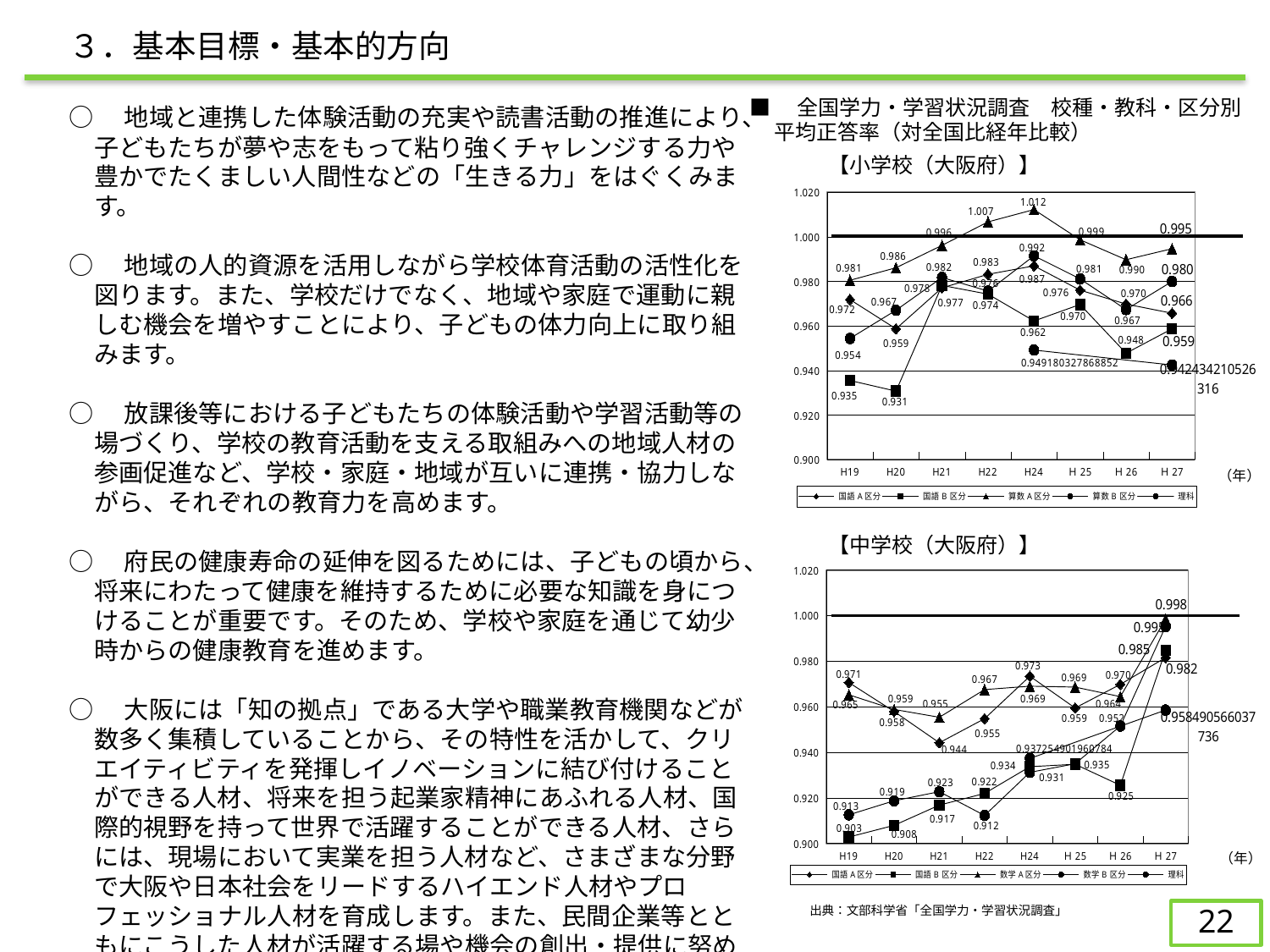
How many years are shown on the x axis of the 【小学校（大阪府）】 chart? 8 How many series does the legend of the 【中学校（大阪府）】 chart list? 5 In the 【中学校（大阪府）】 chart, does the 国語B区分 line rise or fall overall from H19 to H27? rise In the 【小学校（大阪府）】 chart, what is the value for 算数A区分 in H24? 1.012 In the 【中学校（大阪府）】 chart, which is larger for 国語B区分: the value in H19 or in H20? H20 What kind of chart is the 【小学校（大阪府）】 chart? line chart In the 【中学校（大阪府）】 chart, what is the lowest labeled value for 国語B区分? 0.903 In the 【小学校（大阪府）】 chart, what is the lowest labeled value for 国語B区分? 0.931 In the 【小学校（大阪府）】 chart, what is the difference between the 算数A区分 values in H24 and H22? 0.005 In the 【小学校（大阪府）】 chart, is the value for 算数A区分 in H24 greater or less than 1.000? greater In the 【中学校（大阪府）】 chart, what is the value for 数学A区分 in H27? 0.998 In the 【小学校（大阪府）】 chart, which year has the highest labeled value for 算数A区分? H24